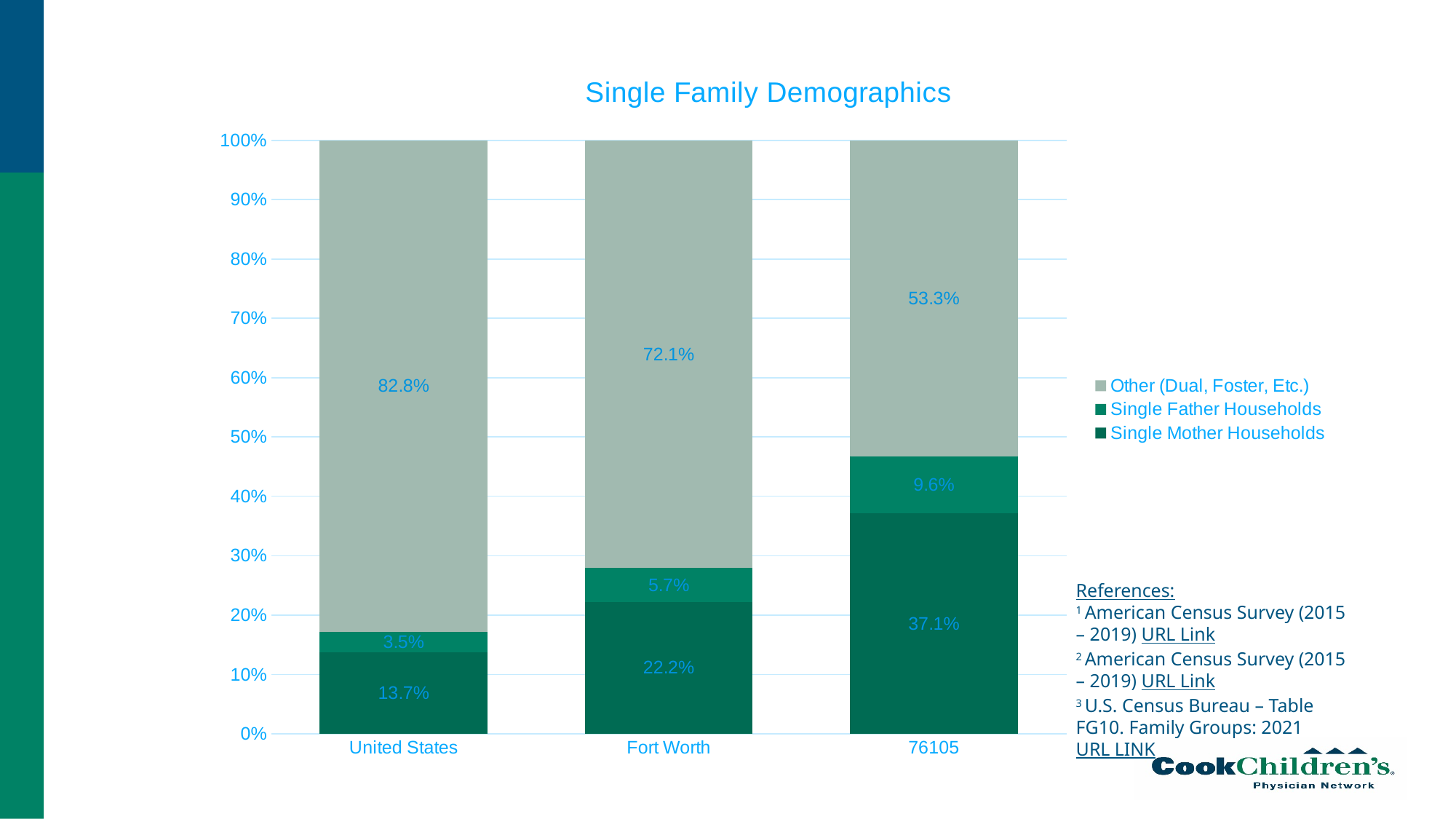
Which is larger: Other (Dual, Foster, Etc.) in Fort Worth or in 76105? Fort Worth Which category has the highest value for Single Mother Households? 76105 Do the Single Father Households values rise or fall from United States to 76105? Rise What is the value for Single Mother Households in Fort Worth? 22.2% What kind of chart is shown on the slide? Stacked bar chart What is the title of the chart? Single Family Demographics What is the value for Other (Dual, Foster, Etc.) in 76105? 53.3% How many categories are shown on the x axis? 3 Which category has the lowest value for Single Father Households? United States What is the difference between the Single Mother Households values for 76105 and the United States? 23.4% What is the value for Single Father Households in the United States? 3.5% How many series does the legend list? 3